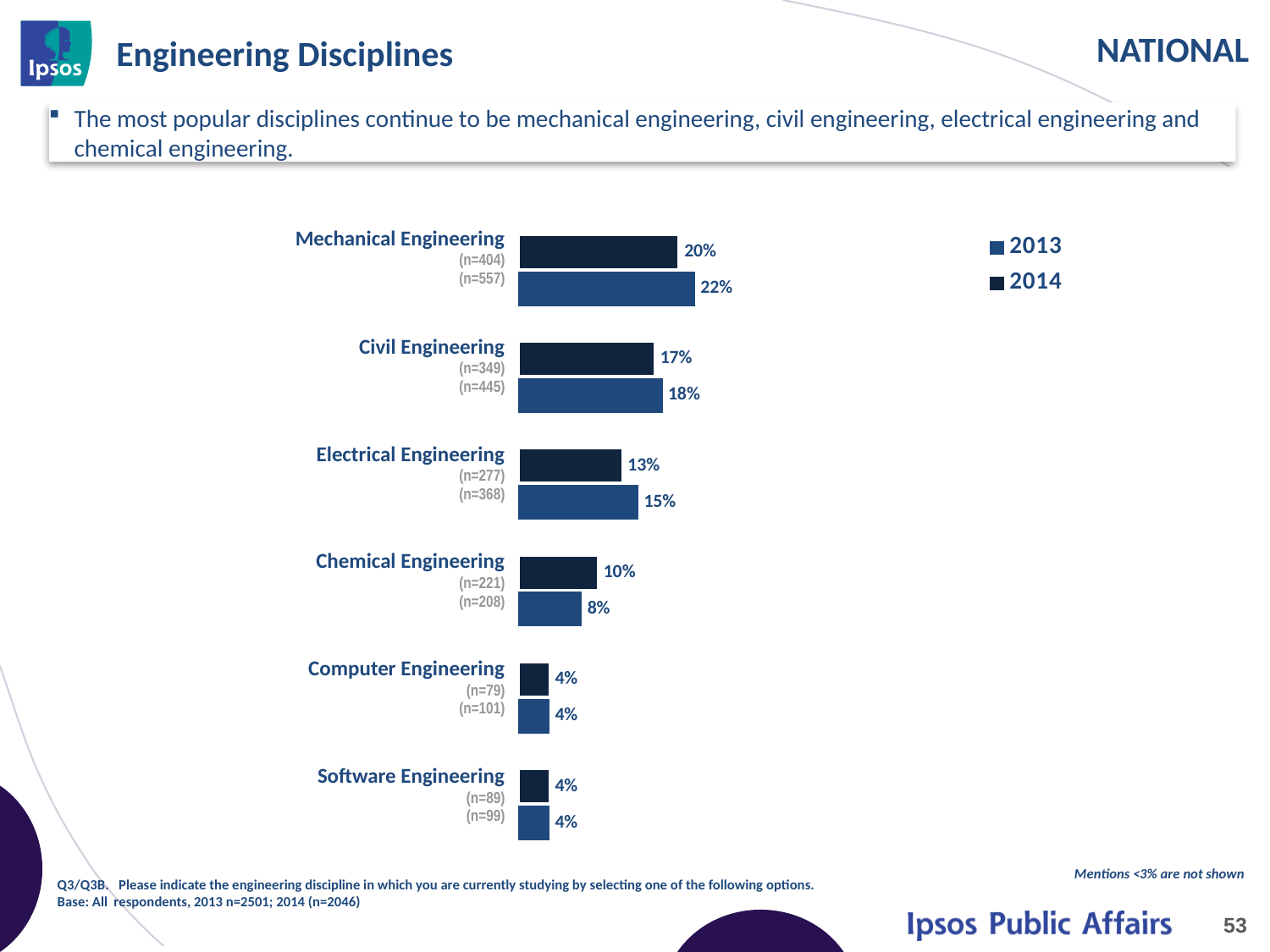
What type of chart is shown on the slide? bar chart What is the 2014 value for Civil Engineering? 17% What is the difference between the 2013 and 2014 values for Electrical Engineering? 2% What are the two series listed in the legend? 2013 and 2014 How many series does the legend list? 2 Which discipline has the highest value in both years? Mechanical Engineering What is the difference between the 2013 and 2014 values for Mechanical Engineering? 2% What is the 2013 value for Electrical Engineering? 15% What is the 2014 value for Chemical Engineering? 10% How many engineering disciplines are shown in the chart? 6 What is the 2013 value for Mechanical Engineering? 22% For Chemical Engineering, which year has the larger value, 2013 or 2014? 2014